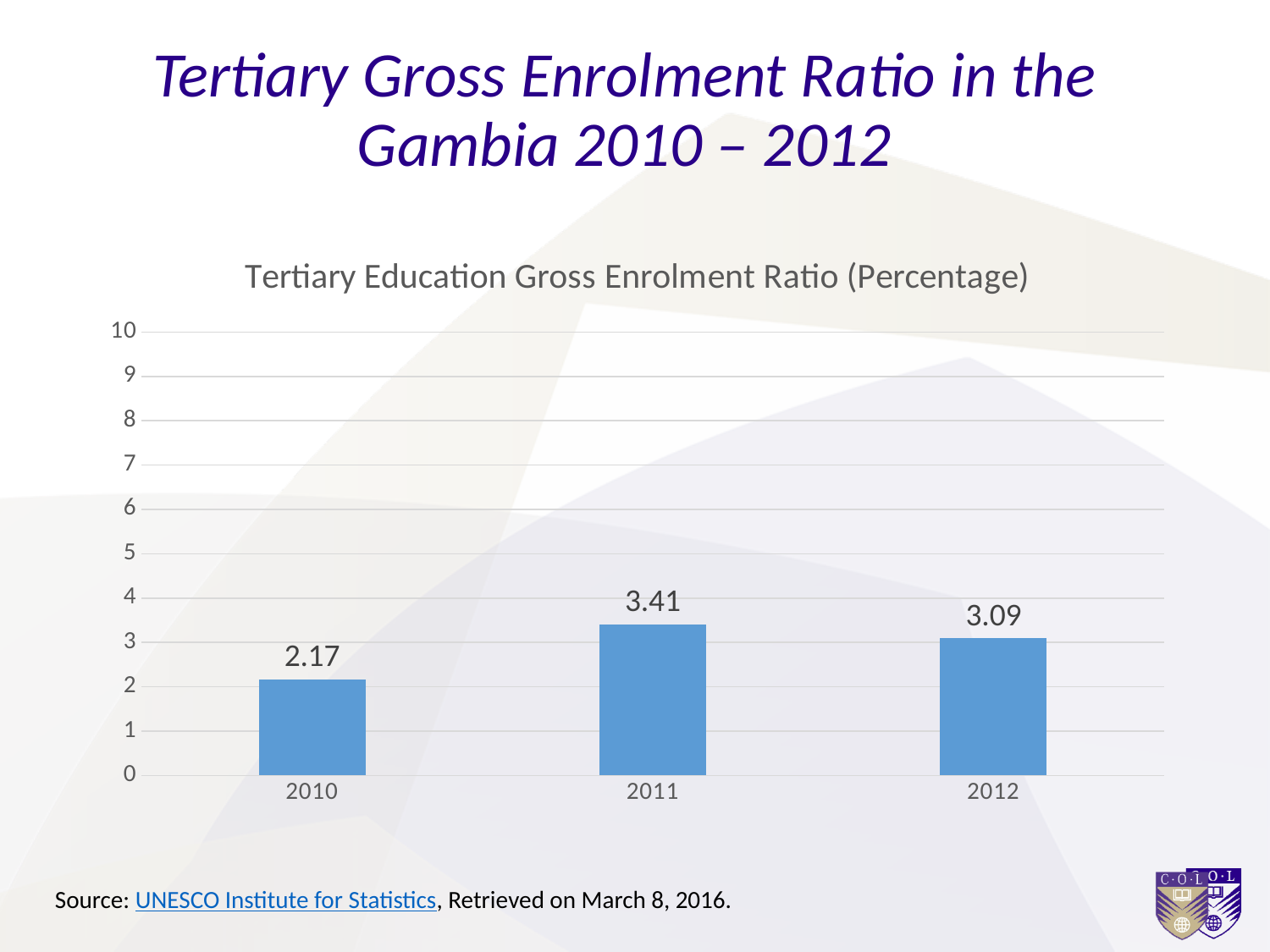
Which year has the lowest tertiary education gross enrolment ratio? 2010 What is the tertiary education gross enrolment ratio for 2012? 3.09 How many years are shown on the chart? 3 What kind of chart is shown on the slide? Bar chart What is the difference between the enrolment ratio in 2011 and in 2012? 0.32 What is the title of the chart? Tertiary Education Gross Enrolment Ratio (Percentage) What is the tertiary education gross enrolment ratio for 2011? 3.41 What is the difference between the enrolment ratio in 2011 and in 2010? 1.24 What is the tertiary education gross enrolment ratio for 2010? 2.17 Is the value for 2011 greater or less than 3? greater Which year has a larger enrolment ratio, 2010 or 2012? 2012 Which year has the highest tertiary education gross enrolment ratio? 2011